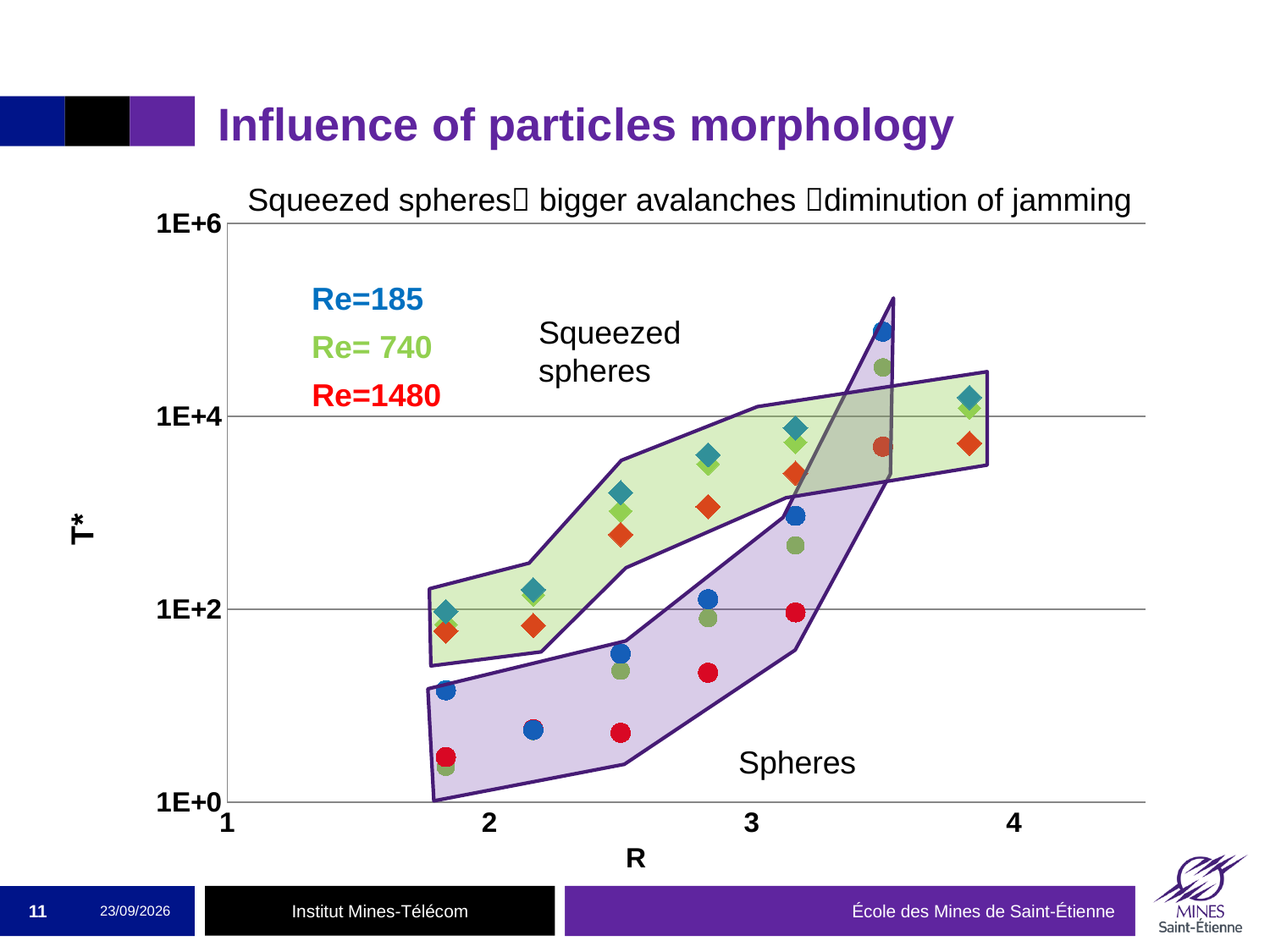
Is the T* value for the spheres at R of about 1.85 greater or less than 1E+2? less What is the label of the x-axis? R Is the T* value for the squeezed spheres at R of about 3.8 greater or less than 1E+2? greater Is the T* value for the Re=185 spheres point at R of about 3.5 greater or less than 1E+4? greater What is the label of the y-axis? T* How do the T* values change as R increases, for both spheres and squeezed spheres? they rise What kind of chart is shown on the slide? scatter chart Which colour represents Re=1480 in the chart? red How many Re values (series) are listed in the chart's legend? 3 At R of about 2.5, which group has the higher T* values, spheres or squeezed spheres? squeezed spheres How many particle groups (shaded regions) are shown on the chart? 2 Which Re series contains the single highest T* point on the chart? Re=185